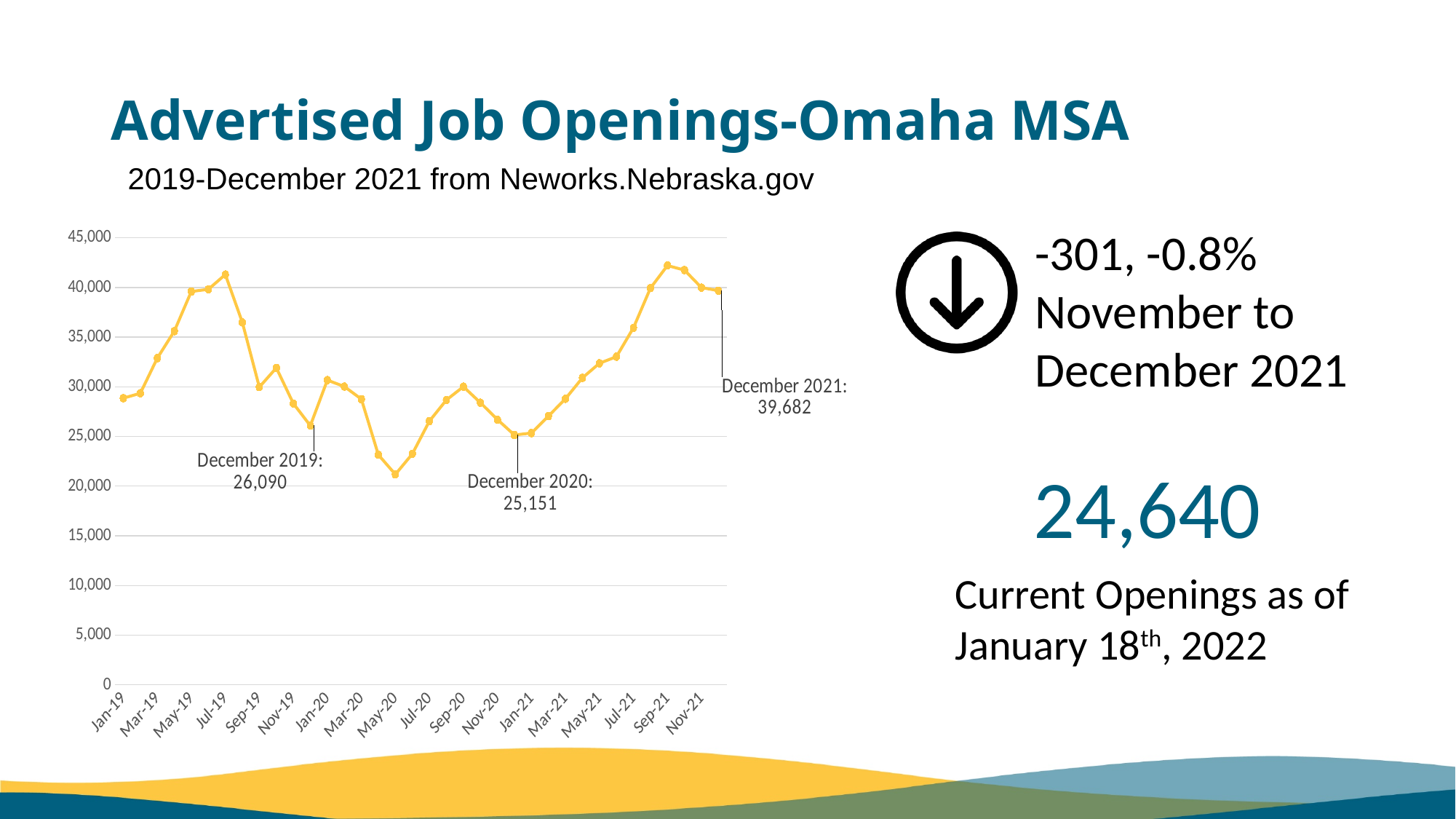
Is the value for Jan-19 greater or less than 30,000? less Is the value for May-20 greater or less than 25,000? less What is the value for December 2020 on the chart? 25,151 What is the difference between the December 2019 value and the December 2020 value? 939 What is the difference between the December 2021 value and the December 2020 value? 14,531 Which month has the lowest value on the chart? May-20 What is the value for December 2019 on the chart? 26,090 Is the value for Sep-21 greater or less than 40,000? greater Do the values rise or fall from Jan-21 to Sep-21? rise Which is larger, the value for December 2019 or the value for December 2020? December 2019 What is the value for December 2021 on the chart? 39,682 What kind of chart is shown on the slide? line chart